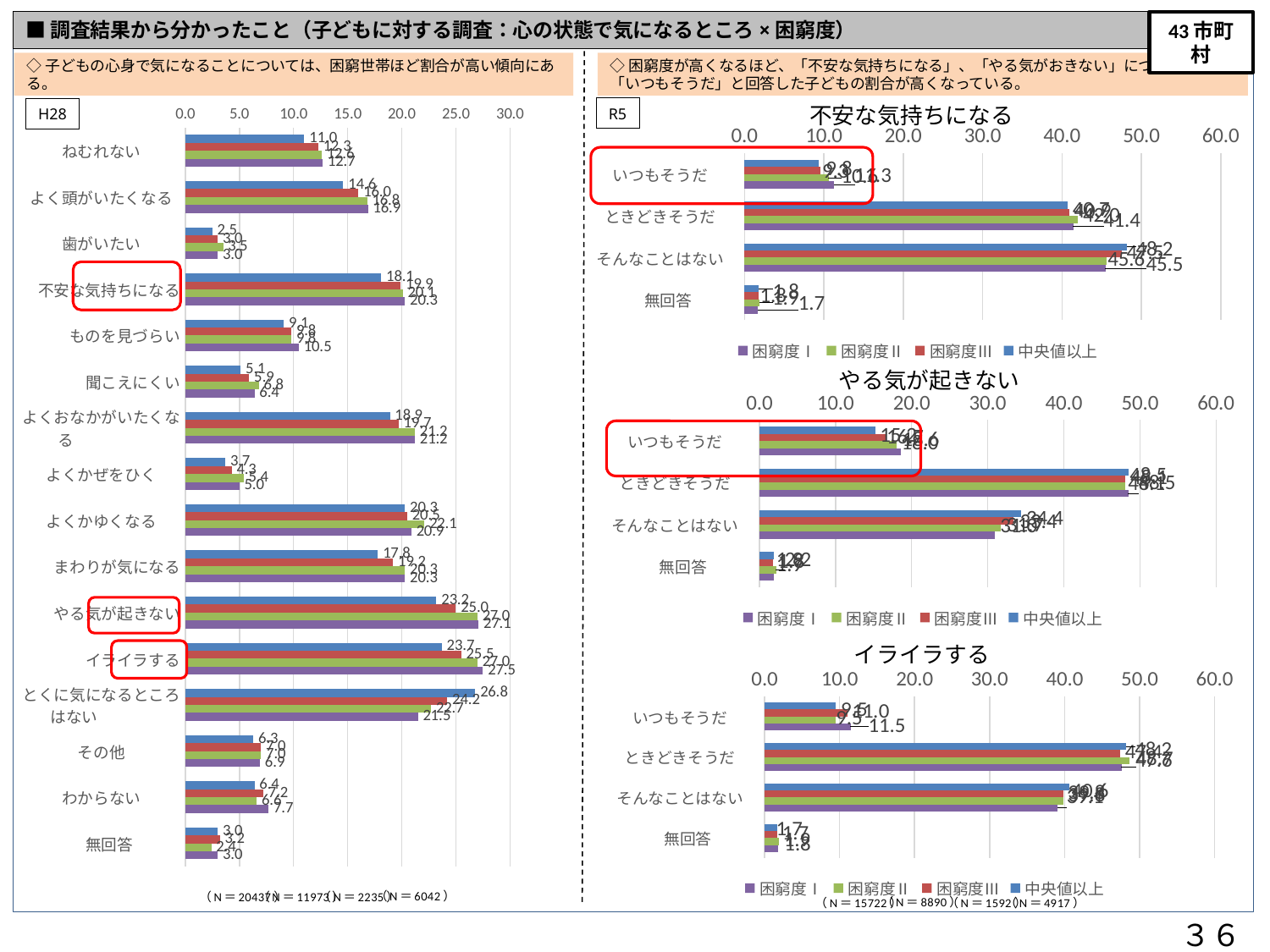
In the 不安な気持ちになる chart, is the value for そんなことはない for 中央値以上 greater or less than 40.0? greater How many categories are shown on the イライラする chart? 4 In the H28 chart on the left, which category has the highest value for the top (blue) bar? とくに気になるところはない What kind of chart is the H28 chart on the left side of the slide? bar chart What are the legend entries of the やる気が起きない chart? 困窮度Ⅰ, 困窮度Ⅱ, 困窮度Ⅲ, 中央値以上 In the H28 chart on the left, what is the difference between the bottom (purple) bar and the top (blue) bar for 不安な気持ちになる? 2.2 How many categories are listed on the H28 chart on the left side of the slide? 16 In the H28 chart on the left, what is the value of the bottom (purple) bar for イライラする? 27.5 How many series does the legend of the 不安な気持ちになる chart list? 4 In the H28 chart on the left, is the top (blue) bar larger for とくに気になるところはない or for ねむれない? とくに気になるところはない In the H28 chart on the left, what is the value of the top (blue) bar for とくに気になるところはない? 26.8 In the H28 chart on the left, what is the value of the top (blue) bar for 不安な気持ちになる? 18.1